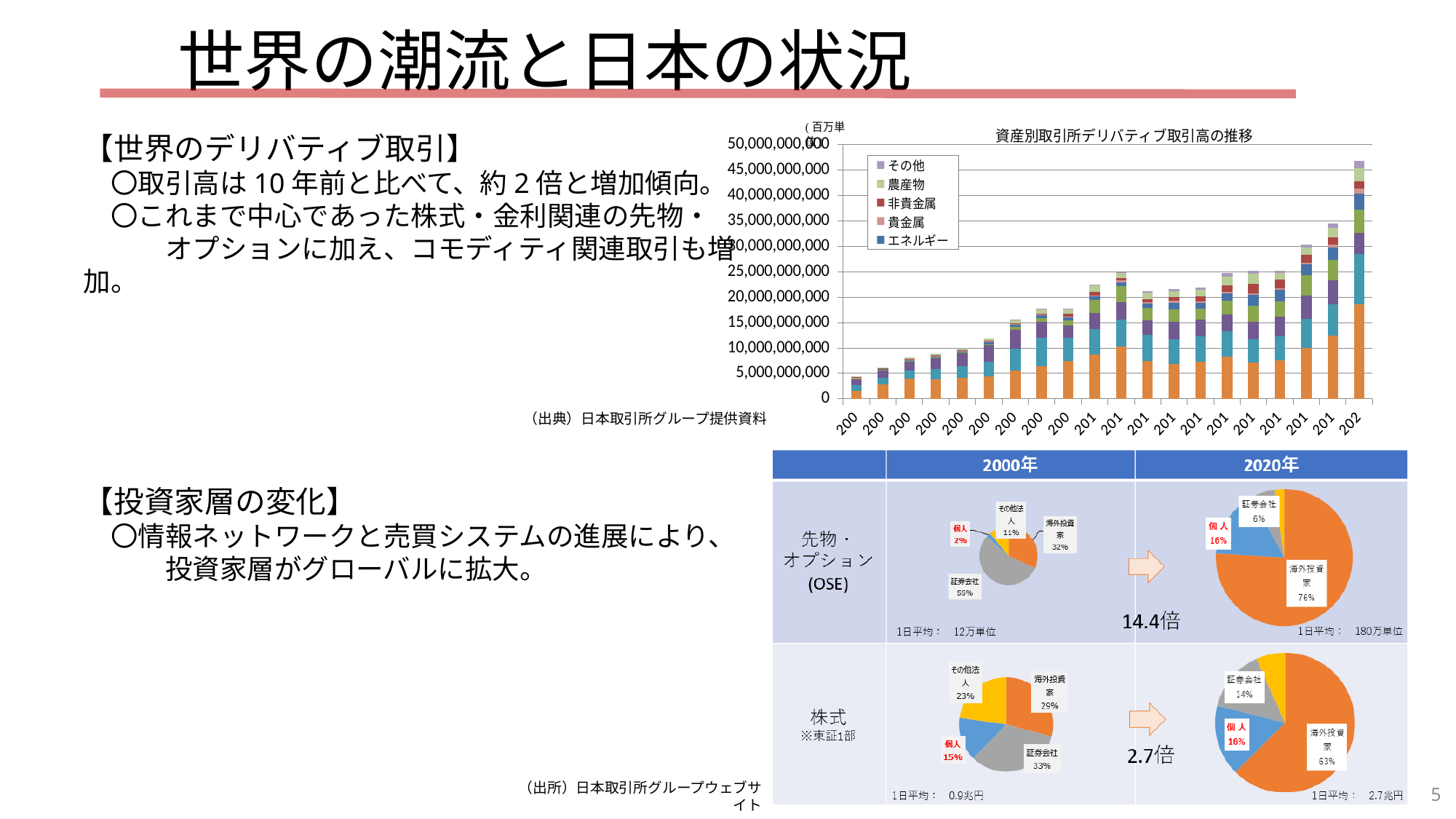
In the chart titled 資産別取引所デリバティブ取引高の推移, which series is listed first in the legend? その他 In the chart titled 資産別取引所デリバティブ取引高の推移, do the total values generally rise or fall from left to right along the x axis? rise In the 株式 2000年 pie chart, what is the difference between the shares of 証券会社 and 個人? 18% In the 先物・オプション (OSE) 2000年 pie chart, what share does 証券会社 have? 55% What kind of chart is the chart titled 資産別取引所デリバティブ取引高の推移? stacked bar chart In the chart titled 資産別取引所デリバティブ取引高の推移, is the total of the rightmost bar greater or less than 40,000,000,000? greater In the 先物・オプション (OSE) 2000年 pie chart, which category has the smallest share? 個人 In the 株式 2020年 pie chart, which category has the largest share? 海外投資家 In the 先物・オプション (OSE) 2020年 pie chart, what share does 海外投資家 have? 76% In the chart titled 資産別取引所デリバティブ取引高の推移, is the total of the leftmost bar greater or less than 5,000,000,000? less In the 株式 2000年 pie chart, what share does その他法人 have? 23% Comparing the 先物・オプション (OSE) pie charts, is the share of 個人 larger in 2000年 or 2020年? 2020年